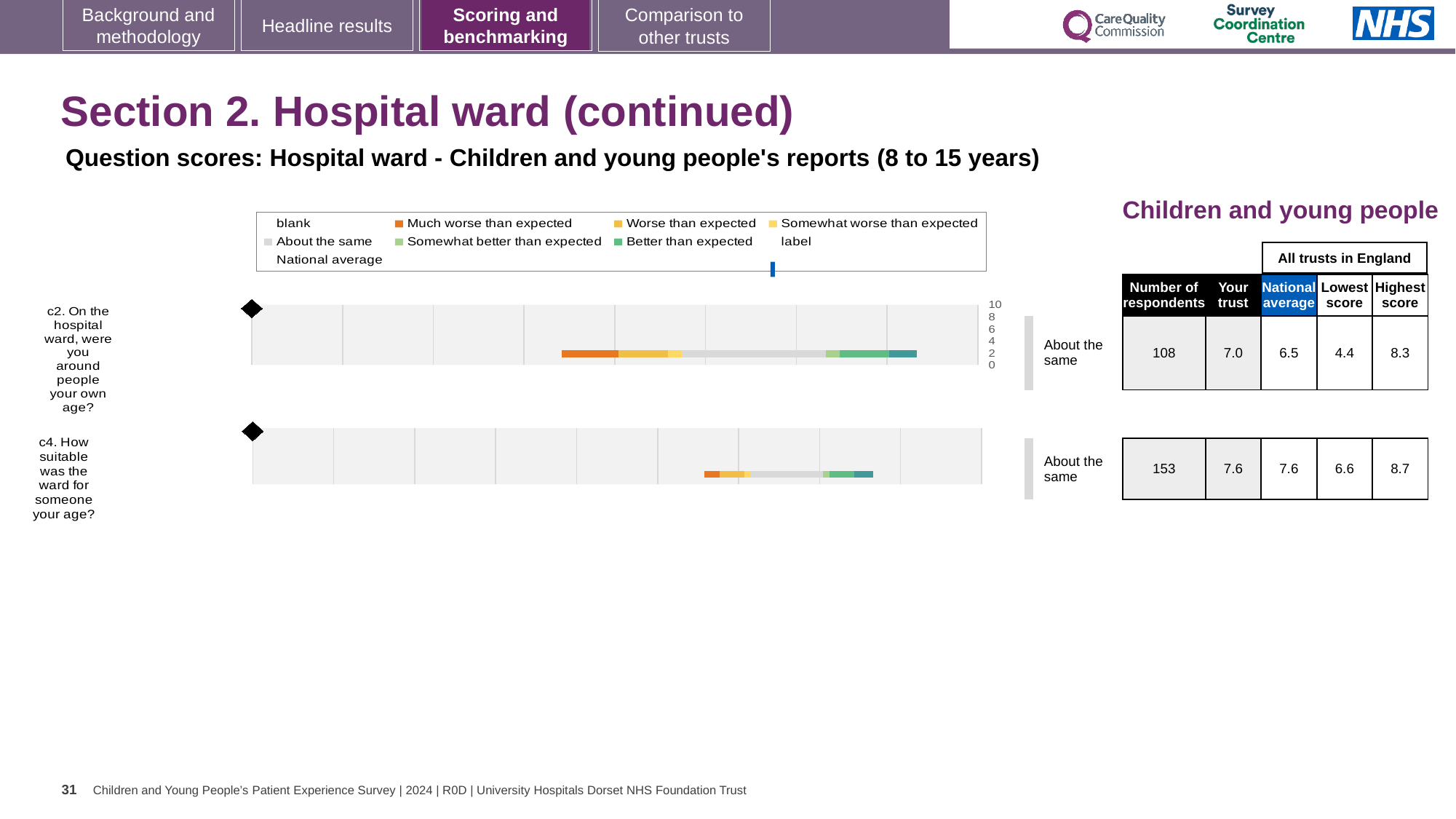
What is the difference between the highest and lowest scores for question c2? 3.9 What is the highest score among all trusts in England for question c4? 8.7 Which of the two questions has more respondents, c2 or c4? c4 What is the 'Your trust' score for question c2 (On the hospital ward, were you around people your own age?)? 7.0 What is the lowest score among all trusts in England for question c2? 4.4 What is the national average score for question c4 (How suitable was the ward for someone your age?)? 7.6 What is the difference between the highest and lowest scores for question c4? 2.1 What benchmark category is shown next to the chart for question c4? About the same For question c2, is the 'Your trust' score higher or lower than the national average? higher What kind of chart is used to show the question scores on this slide? bar chart How many respondents answered question c2? 108 How many questions (categories) are plotted in the chart? 2